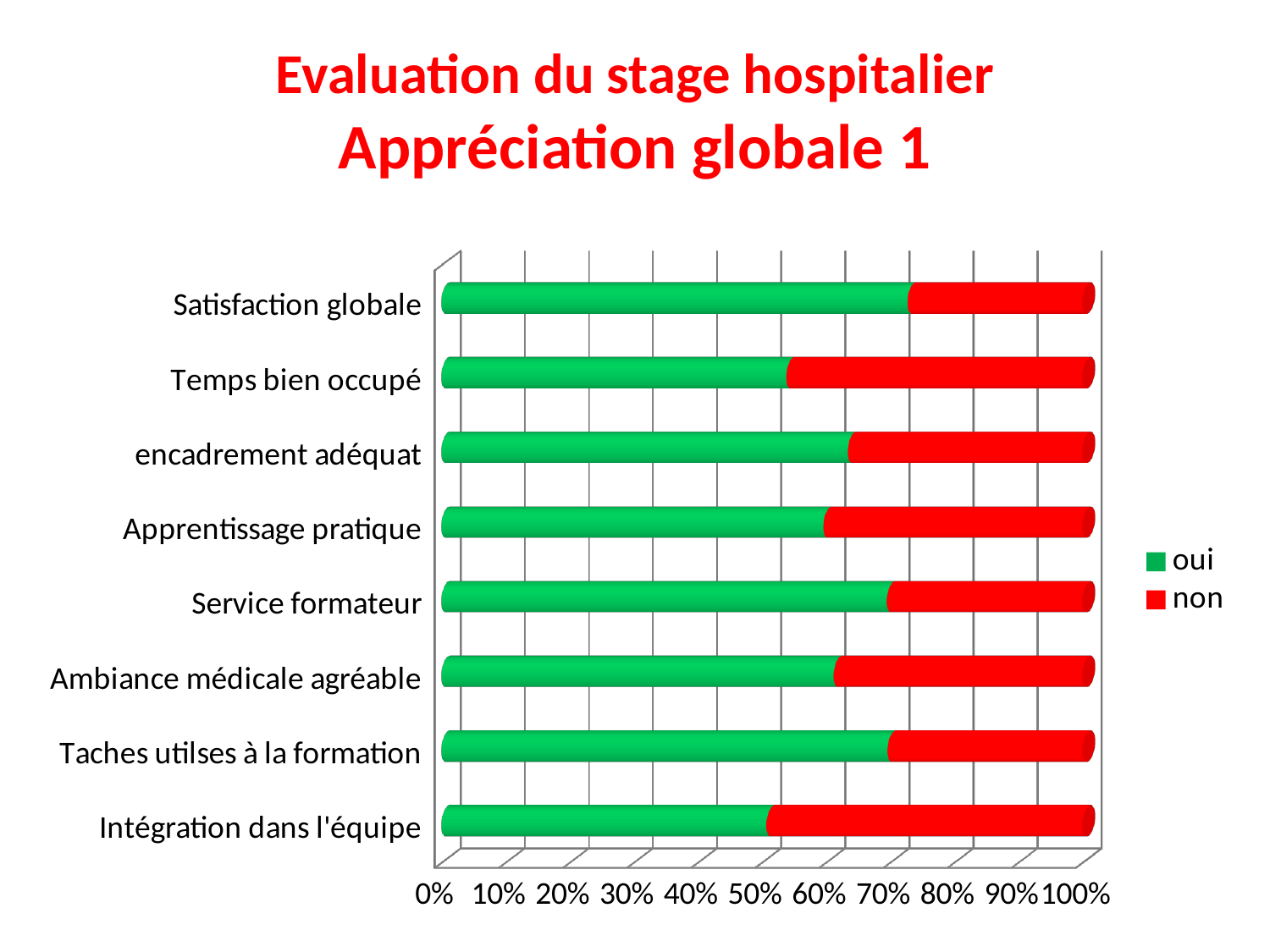
Which category has the highest 'oui' share? Satisfaction globale How many categories are plotted on the chart? 8 What kind of chart is shown on the slide? bar chart Which has a larger 'oui' share, Satisfaction globale or Temps bien occupé? Satisfaction globale Is the 'oui' value for Satisfaction globale greater or less than 60%? greater Is the 'oui' value for Apprentissage pratique greater or less than 70%? less Which series is shown in green? oui What are the two legend entries of the chart? oui and non Is the 'oui' value for Service formateur greater or less than 60%? greater How many series does the legend list? 2